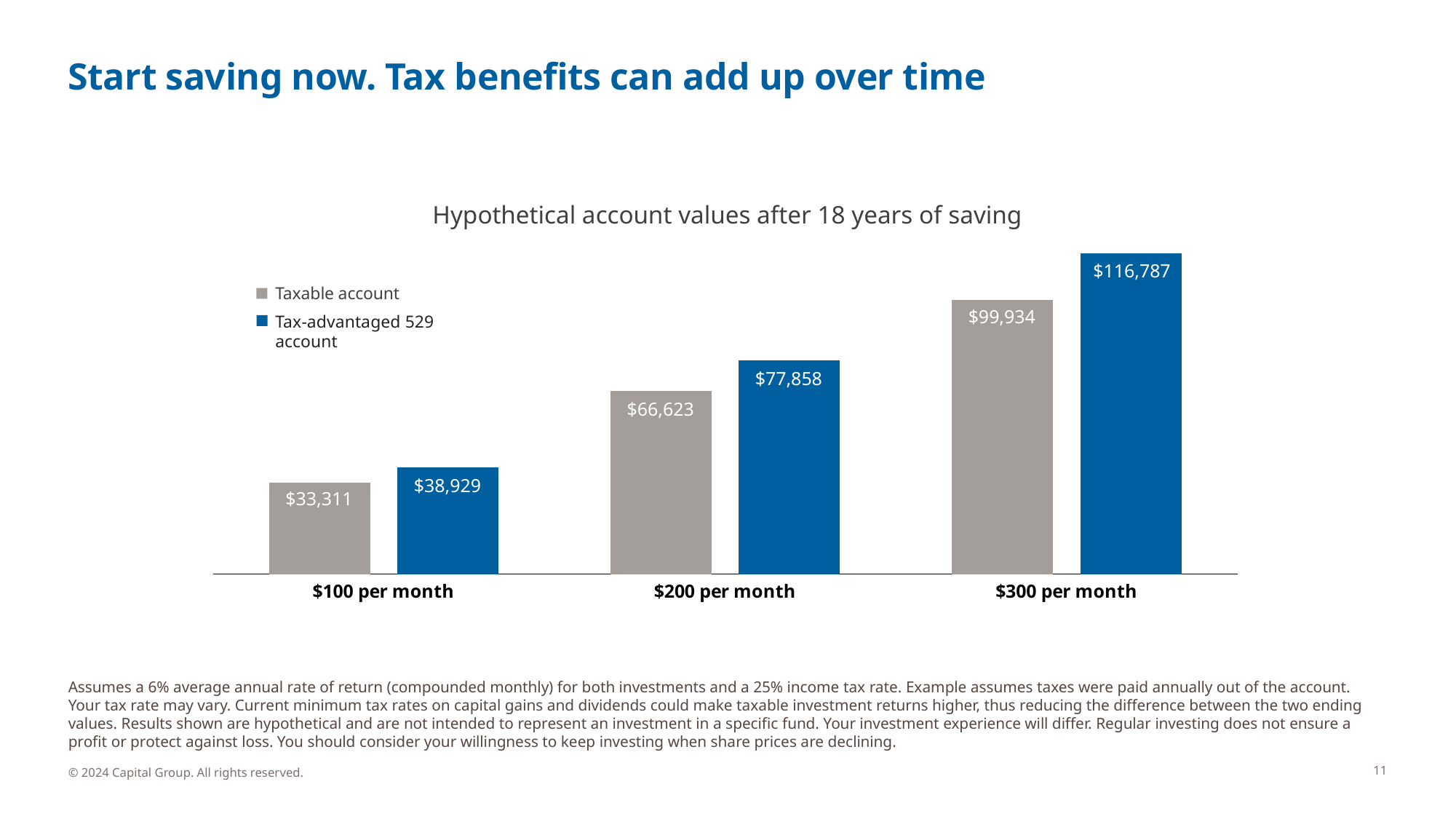
Which contribution level has the lowest Taxable account value? $100 per month Which contribution level has the highest Tax-advantaged 529 account value? $300 per month What is the difference between the Tax-advantaged 529 account and the Taxable account at $300 per month? $16,853 How many contribution levels are shown on the x axis? 3 What kind of chart is shown on the slide? Bar chart At $100 per month, which is larger: the Taxable account or the Tax-advantaged 529 account? Tax-advantaged 529 account What is the value of the Taxable account at $100 per month? $33,311 How many series does the legend list? 2 What is the value of the Tax-advantaged 529 account at $200 per month? $77,858 What is the difference between the Tax-advantaged 529 account and the Taxable account at $200 per month? $11,235 What is the value of the Taxable account at $300 per month? $99,934 What is the value of the Tax-advantaged 529 account at $300 per month? $116,787